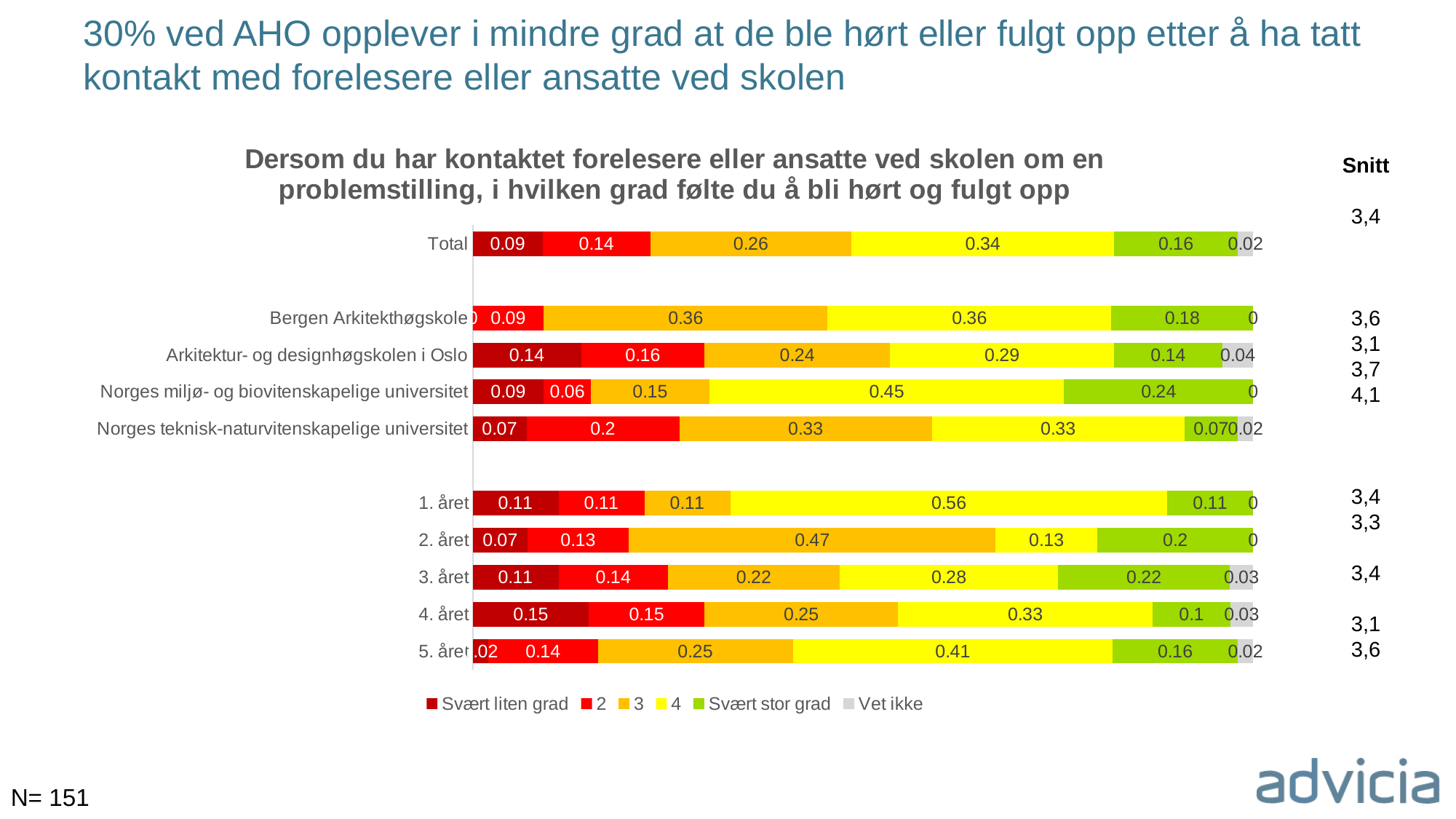
What kind of chart is shown on the slide? Stacked bar chart Which is larger: the '3' value for 2. året or the '3' value for 3. året? 2. året How many series does the legend list? 6 What is the value for 'Svært liten grad' for Arkitektur- og designhøgskolen i Oslo? 0.14 What is the value for '4' in the Total bar? 0.34 What is the value for 'Svært stor grad' for Norges miljø- og biovitenskapelige universitet? 0.24 What is the 'Snitt' (average) shown for Arkitektur- og designhøgskolen i Oslo? 3,1 Which category has the highest value for the series '4'? 1. året Which category has the highest value for 'Svært stor grad'? Norges miljø- og biovitenskapelige universitet What is the difference between the 'Svært liten grad' value for Arkitektur- og designhøgskolen i Oslo and for Total? 0.05 What is the value for '3' for 2. året? 0.47 How many categories (bars) are plotted in the chart? 10